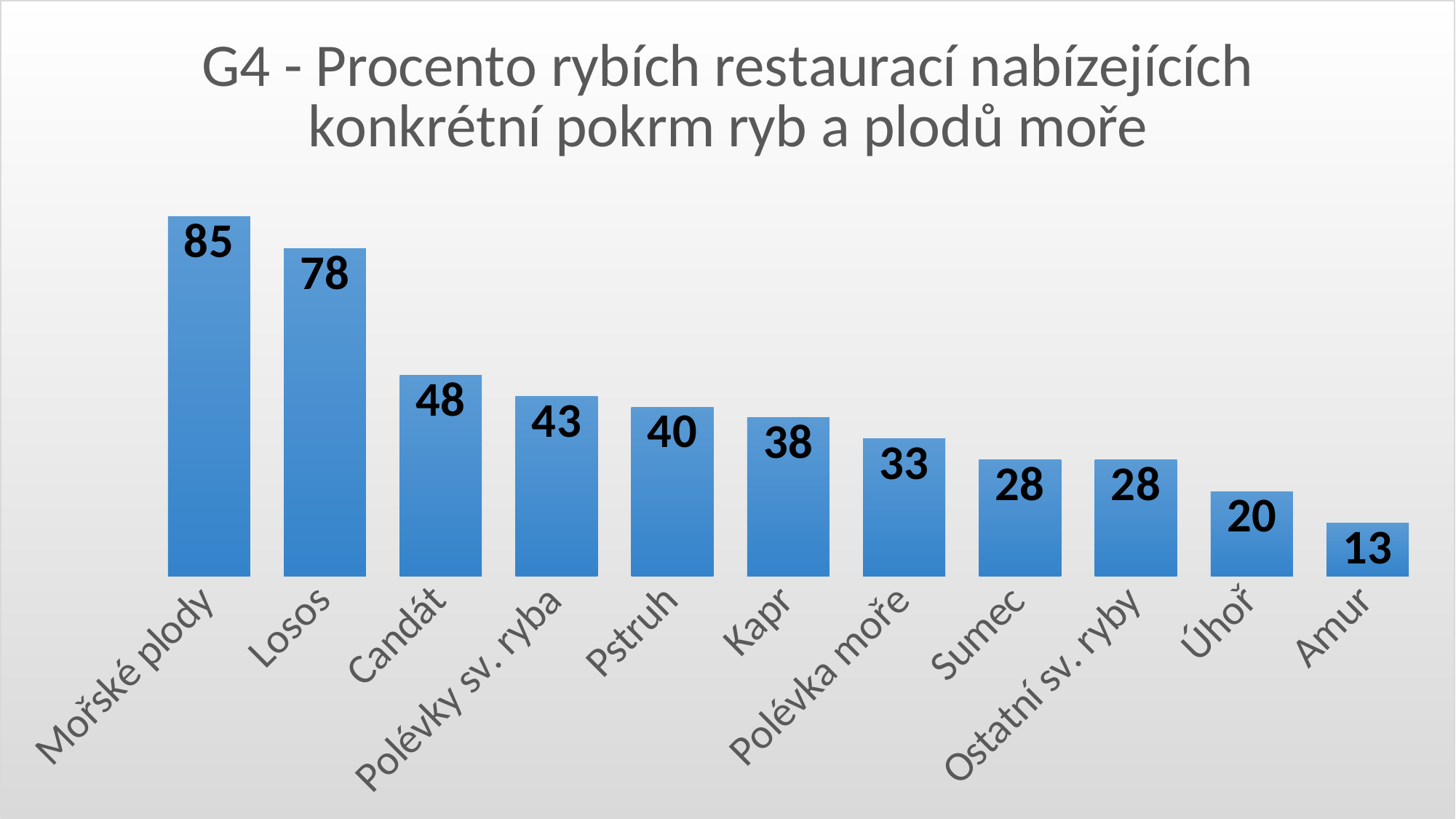
Which category has the highest value? Mořské plody Which category has the lowest value? Amur What is the value for Pstruh? 40 How many categories are shown in the chart? 11 Which is larger, the value for Úhoř or the value for Amur? Úhoř What is the title of the chart? G4 - Procento rybích restaurací nabízejících konkrétní pokrm ryb a plodů moře What is the value for Losos? 78 What kind of chart is this? bar chart What is the difference between the values for Candát and Kapr? 10 What is the difference between the values for Mořské plody and Losos? 7 Do the values rise or fall from left to right along the x axis? fall What is the value for Polévka moře? 33